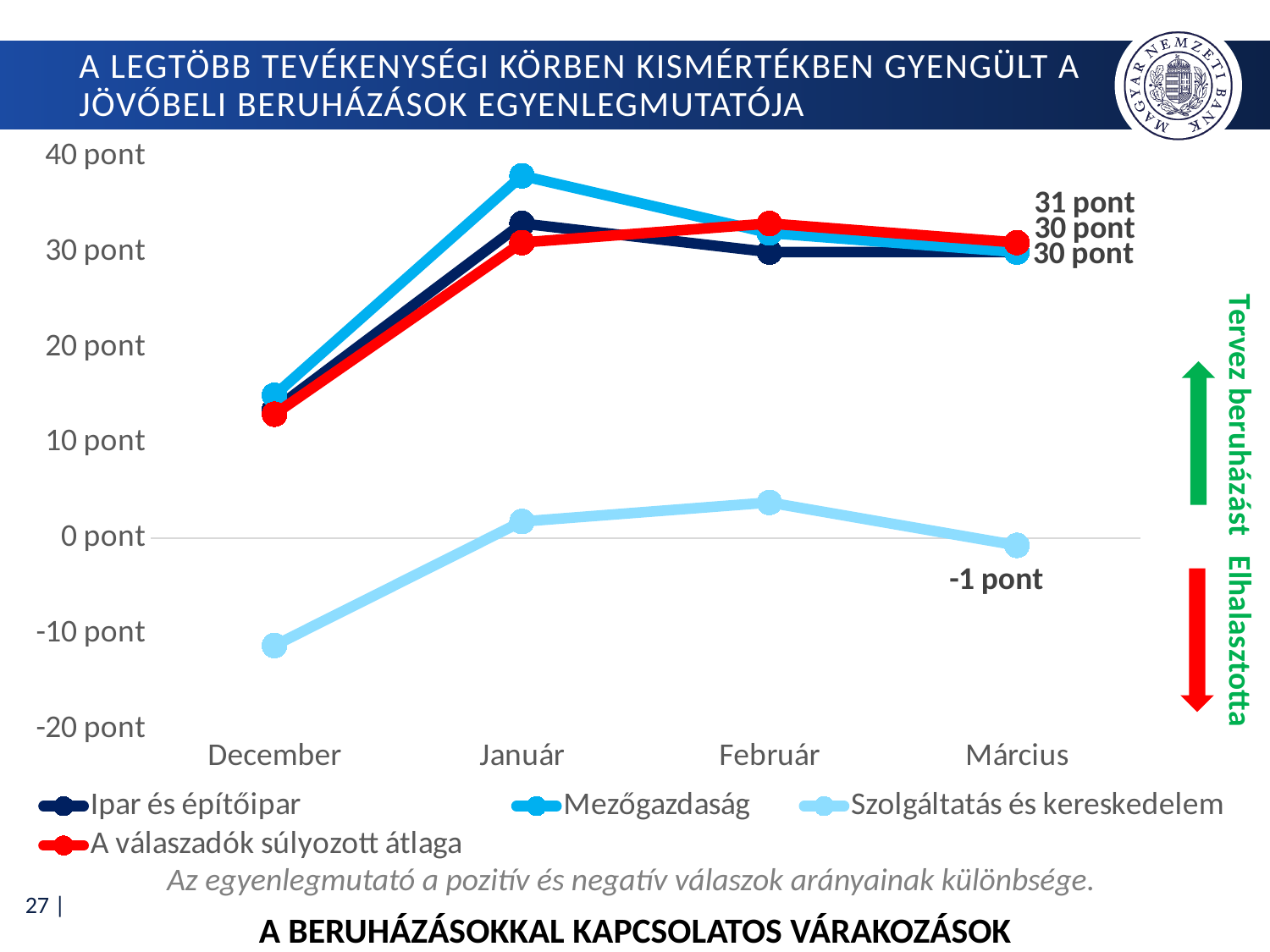
What kind of chart is shown on the slide? line chart Does the Mezőgazdaság line rise or fall from Január to Március? fall Which is larger in Január, Mezőgazdaság or Szolgáltatás és kereskedelem? Mezőgazdaság What is the value for Szolgáltatás és kereskedelem in Március? -1 pont Which series is drawn in red? A válaszadók súlyozott átlaga How many months are shown on the x axis? 4 Is the value for Ipar és építőipar in December greater or less than 20 pont? less Is the value for Szolgáltatás és kereskedelem in December greater or less than 0 pont? less Which series has the lowest value in December? Szolgáltatás és kereskedelem How many series does the legend list? 4 Is the value for Mezőgazdaság in Január greater or less than 30 pont? greater In which month does Mezőgazdaság reach its highest value? Január